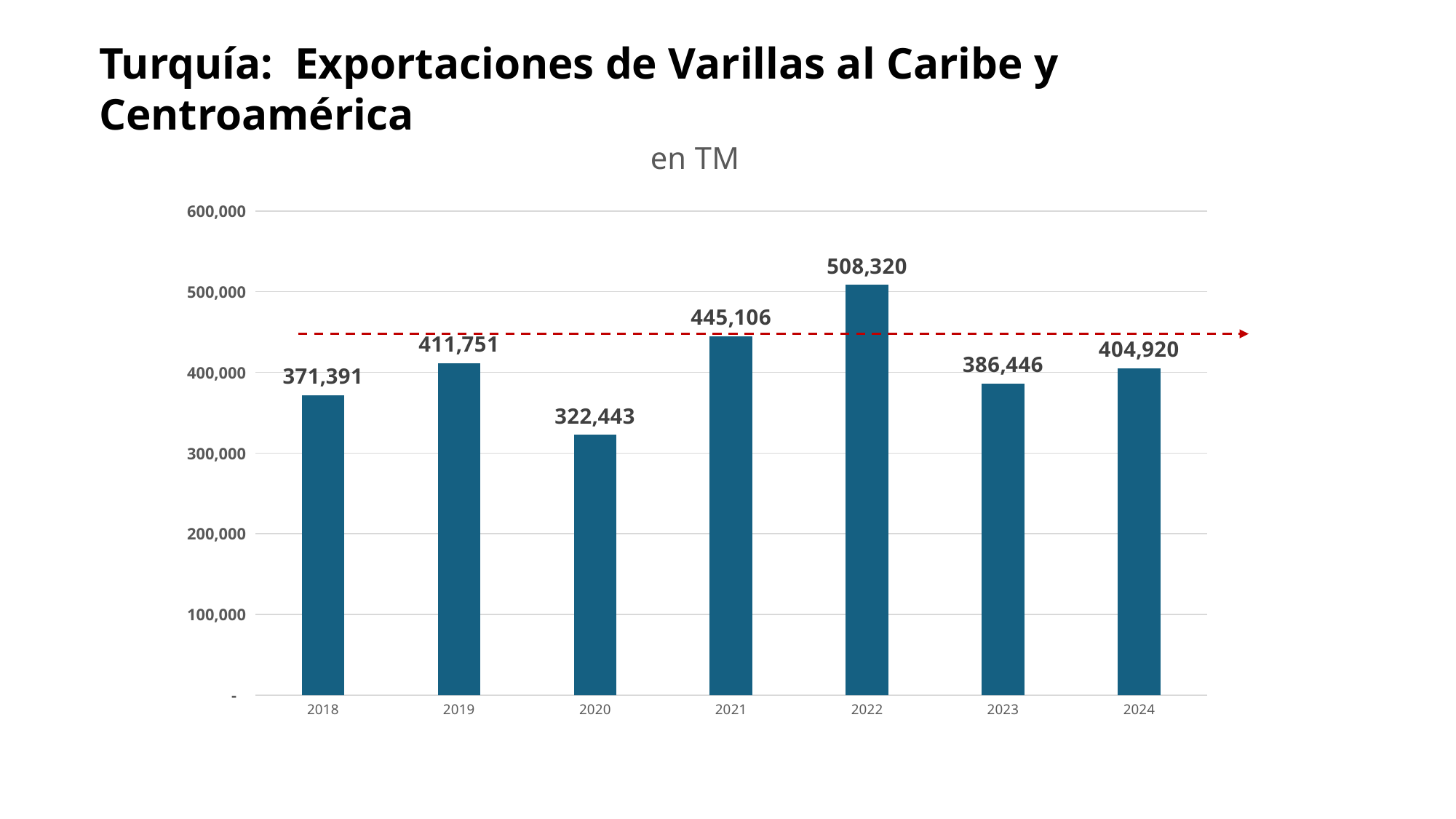
How many years are shown on the x axis? 7 What kind of chart is shown on the slide? bar chart What is the difference between the 2022 and 2020 values? 185,877 What is the difference between the 2024 and 2023 values? 18,474 What unit is given in the chart subtitle? TM What value is shown for 2020? 322,443 Which year has a larger value, 2019 or 2021? 2021 What was the value of Turkey's rebar exports to the Caribbean and Central America in 2022? 508,320 What value is shown for 2024? 404,920 Is the value for 2023 greater or less than 400,000? less Which year has the lowest export value? 2020 Which year has the highest export value? 2022